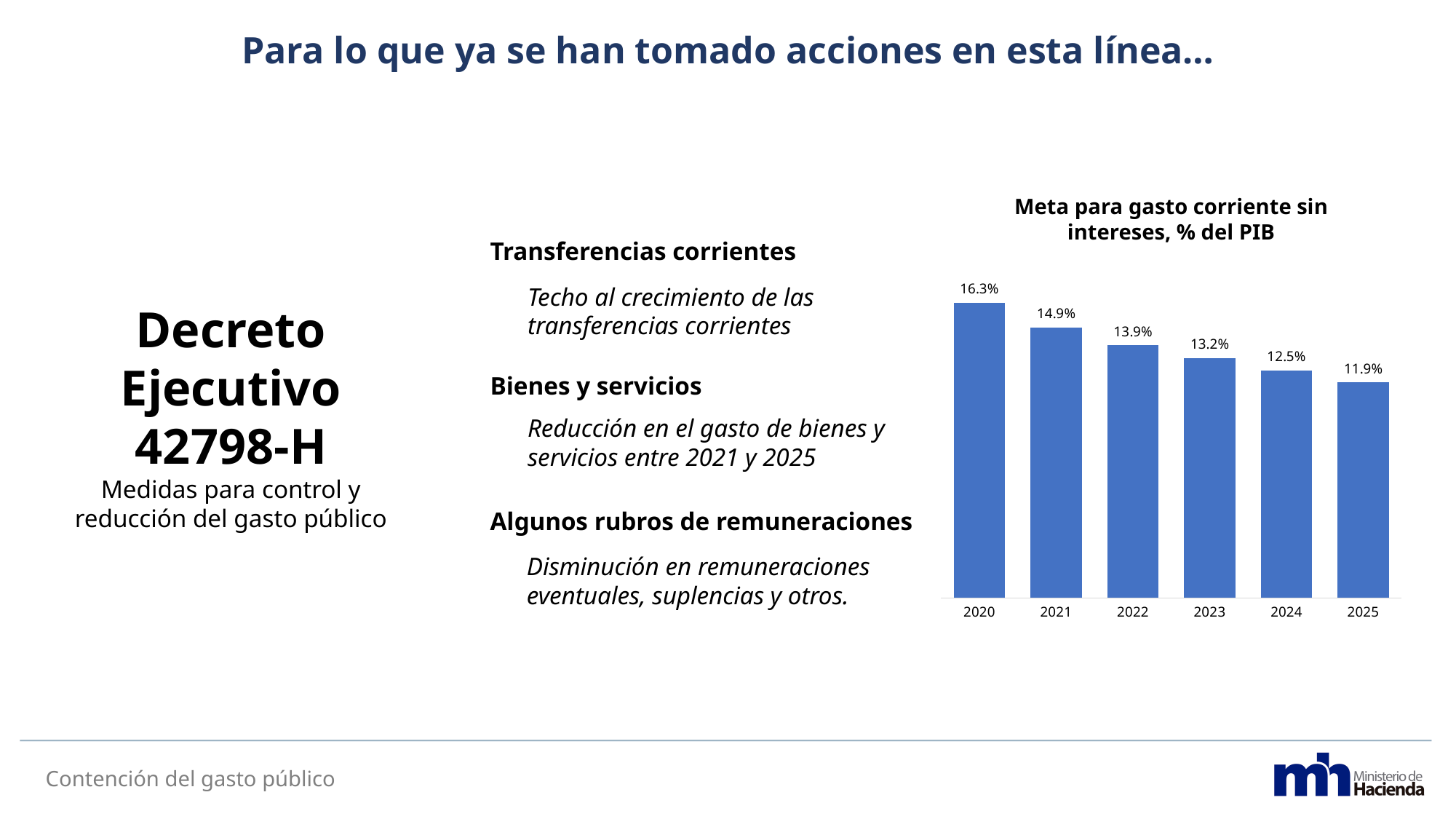
What is the value for 2025 in the chart? 11.9% Which year has the lowest value in the chart? 2025 Which year has the highest value in the chart? 2020 What is the value for 2023 in the chart? 13.2% What is the title of the chart? Meta para gasto corriente sin intereses, % del PIB Which is larger, the value for 2022 or the value for 2024? 2022 How many years are shown on the x axis of the chart? 6 What is the value for 2020 in the chart? 16.3% Do the values rise or fall from 2020 to 2025? Fall What is the difference between the values for 2021 and 2022? 1.0% What kind of chart is shown on the slide? Bar chart What is the difference between the values for 2020 and 2025? 4.4%